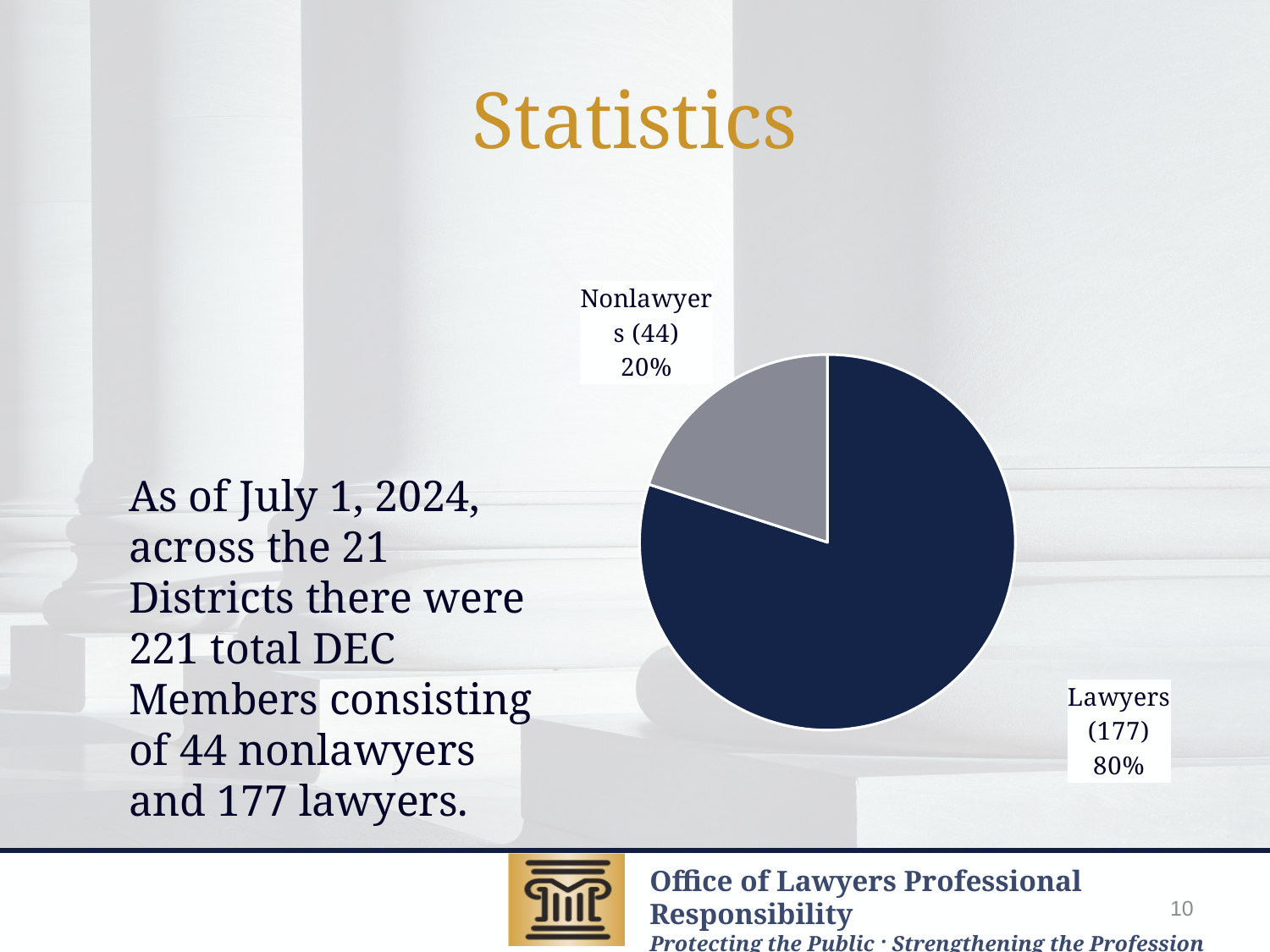
What is the total number of members represented by the two slices of the pie chart? 221 How many slices does the pie chart have? 2 What is the number of Lawyers shown in the pie chart? 177 What is the number of Nonlawyers shown in the pie chart? 44 What is the difference between the number of Lawyers and the number of Nonlawyers? 133 What colour is the Lawyers slice of the pie chart? dark navy blue What percentage share of the pie do Lawyers represent? 80% What percentage share of the pie do Nonlawyers represent? 20% Which slice of the pie chart is the smallest? Nonlawyers What kind of chart is shown on the slide? pie chart Which is larger, the Lawyers slice or the Nonlawyers slice? Lawyers Which slice of the pie chart is the largest? Lawyers